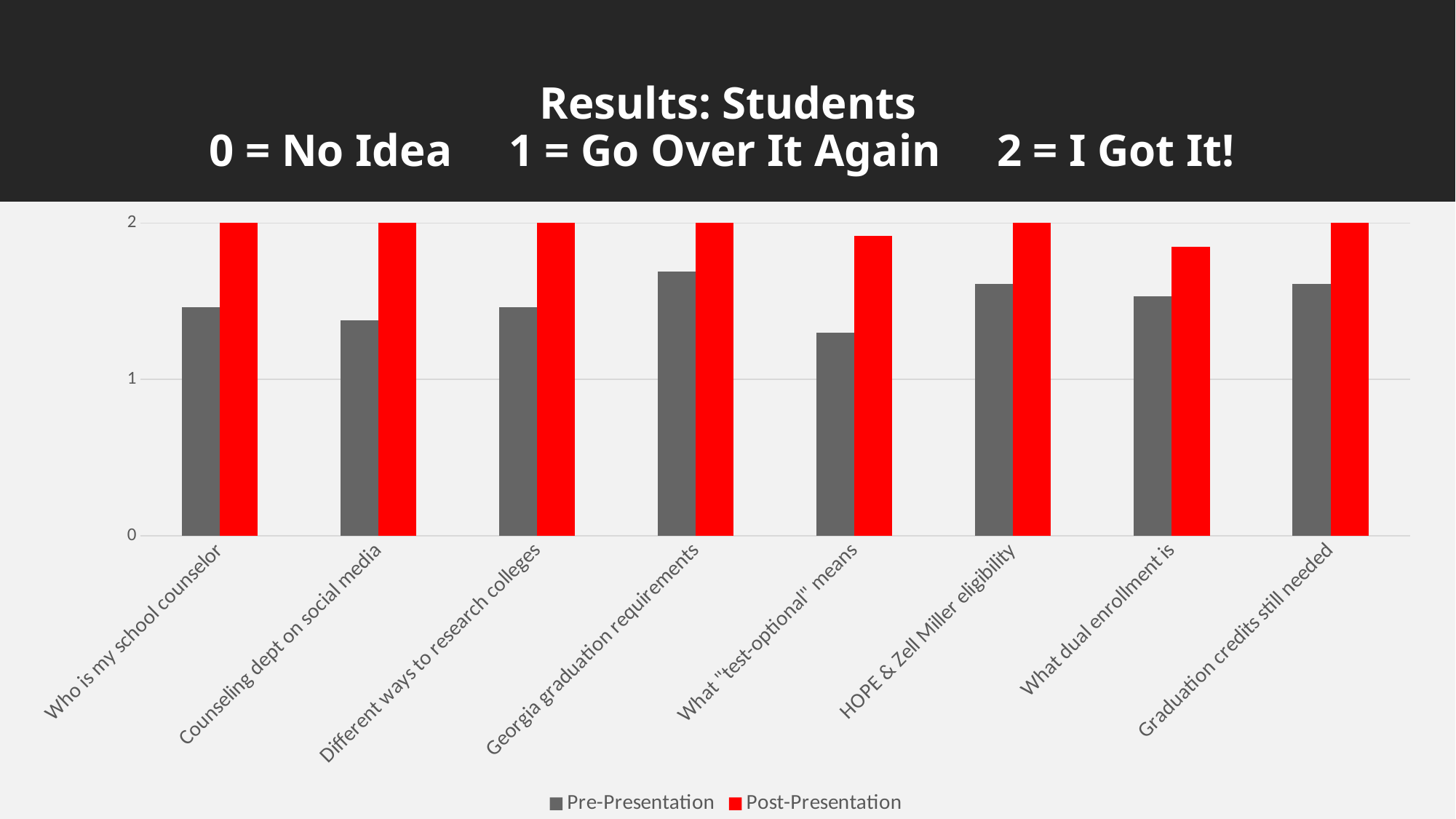
Which category has the lowest Pre-Presentation value? What "test-optional" means What are the two series named in the legend? Pre-Presentation and Post-Presentation Is the Post-Presentation value for "What dual enrollment is" greater or less than 1? greater How many series does the chart's legend list? 2 Is the Pre-Presentation value for "Counseling dept on social media" greater or less than 1? greater How many categories are shown on the x axis of the chart? 8 What is the Post-Presentation value for "HOPE & Zell Miller eligibility"? 2 Which category has the highest Pre-Presentation value? Georgia graduation requirements Which colour represents the Post-Presentation series in the chart? Red What is the Post-Presentation value for "Who is my school counselor"? 2 For "What dual enrollment is", which is larger: the Pre-Presentation or the Post-Presentation value? Post-Presentation What kind of chart is shown on the slide? Bar chart